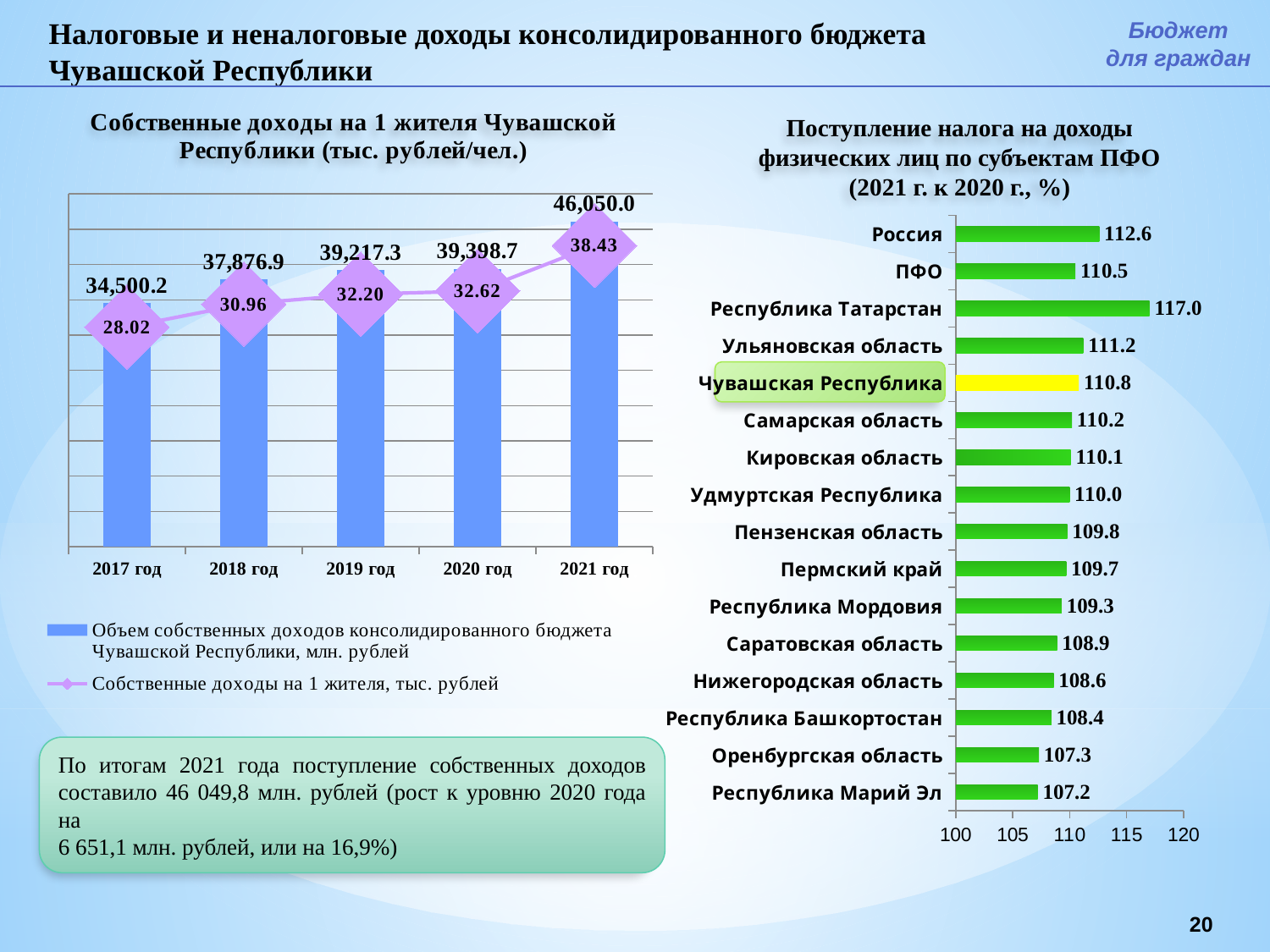
In the right chart, which region has the lowest value? Республика Марий Эл In the left chart, do the line values rise or fall from 2017 год to 2021 год? rise In the left chart, what is the value of the line marker (Собственные доходы на 1 жителя) for 2019 год? 32.20 In the right chart, which is larger: the value for Ульяновская область or the value for Самарская область? Ульяновская область In the right chart, how many categories (bars) are shown? 16 What type of chart is the right chart? bar chart In the left chart, which year has the lowest bar value? 2017 год In the left chart, how many series does the legend list? 2 In the left chart, what is the difference between the bar values for 2021 год and 2020 год? 6,651.3 In the right chart (Поступление налога на доходы физических лиц по субъектам ПФО), what is the value for Чувашская Республика? 110.8 In the left chart (Собственные доходы на 1 жителя Чувашской Республики), what is the value of the bar for 2021 год? 46,050.0 In the right chart, which region has the highest value? Республика Татарстан